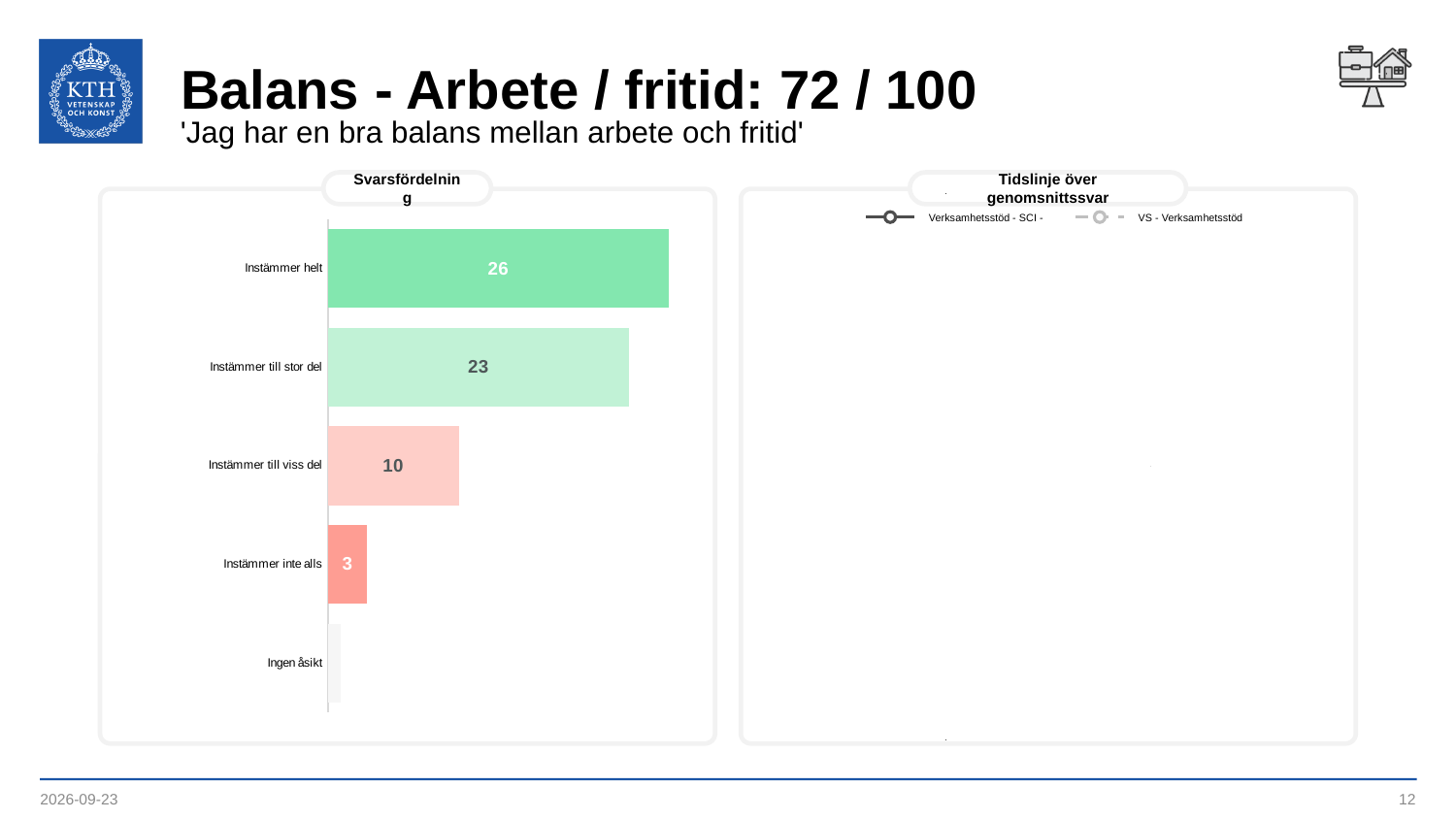
In the 'Svarsfördelning' chart, which category has the lowest value? Ingen åsikt In the 'Svarsfördelning' chart, which category has the highest value? Instämmer helt What kind of chart is the 'Svarsfördelning' chart? Bar chart In the 'Svarsfördelning' chart, what is the value for 'Instämmer till stor del'? 23 In the 'Svarsfördelning' chart, what is the value for 'Instämmer helt'? 26 In the 'Svarsfördelning' chart, what is the difference between 'Instämmer helt' and 'Instämmer till stor del'? 3 In the 'Svarsfördelning' chart, what is the difference between 'Instämmer till stor del' and 'Instämmer till viss del'? 13 How many series does the legend of the 'Tidslinje över genomsnittssvar' chart list? 2 In the 'Svarsfördelning' chart, what is the value for 'Instämmer till viss del'? 10 In the 'Svarsfördelning' chart, what is the value for 'Instämmer inte alls'? 3 How many categories are shown in the 'Svarsfördelning' chart? 5 In the 'Svarsfördelning' chart, which is larger: 'Instämmer till viss del' or 'Instämmer inte alls'? Instämmer till viss del